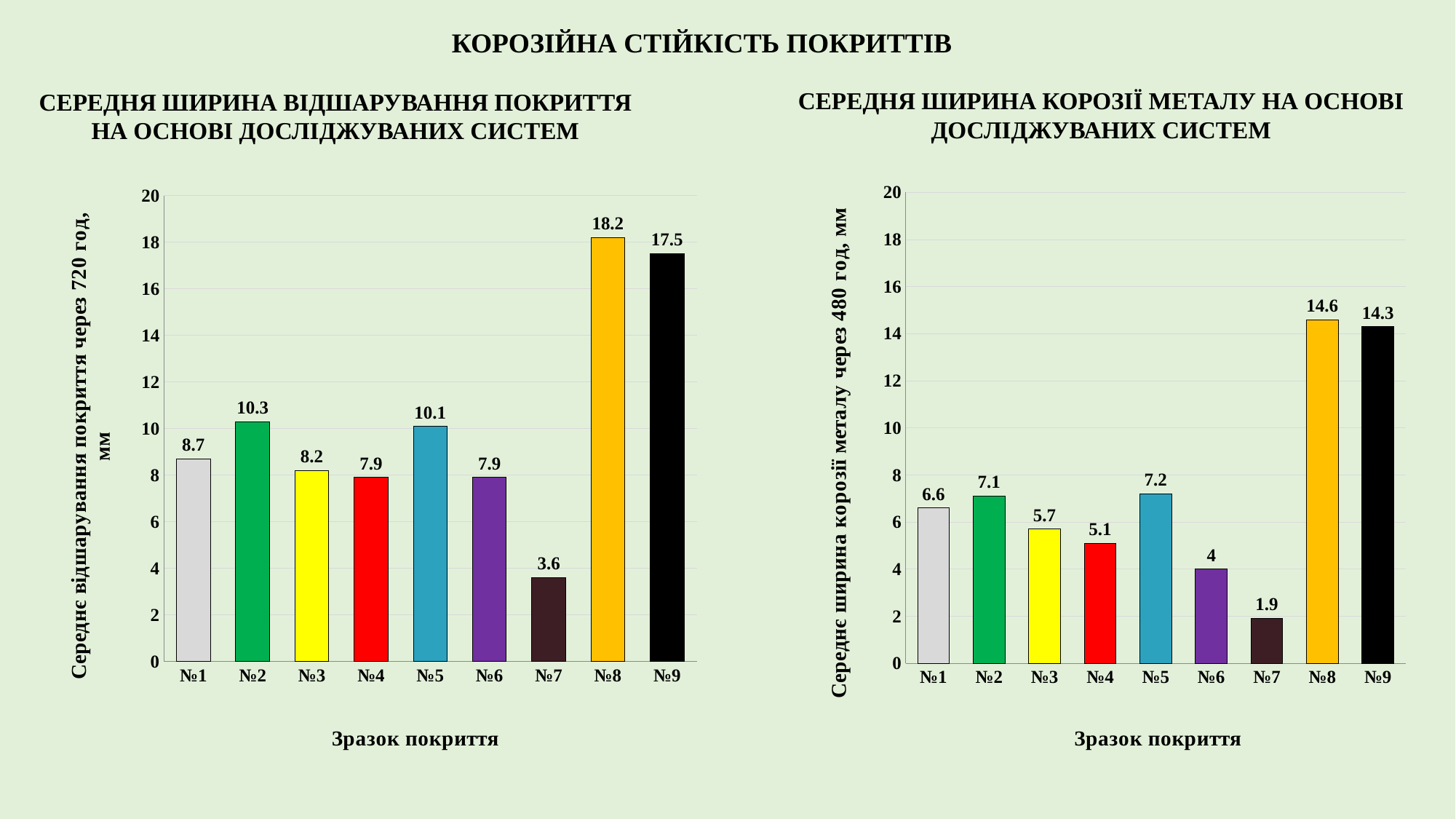
How many samples (categories) are shown on the x axis of the right chart? 9 What is the x-axis title of the left chart? Зразок покриття In the right chart (average metal corrosion width), what is the value for sample №7? 1.9 In the right chart, what is the value for sample №6? 4 In the left chart (average coating delamination width), what is the value for sample №8? 18.2 What type of chart is the left chart? bar chart In the right chart, what is the difference between the values for sample №5 and sample №6? 3.2 In the left chart, which sample has the lowest value? №7 In the right chart, which sample has the highest value? №8 In the left chart, what is the difference between the values for sample №8 and sample №9? 0.7 In the right chart, is the value for sample №9 greater or less than 10? greater In the left chart, which is larger: the value for sample №2 or sample №3? №2